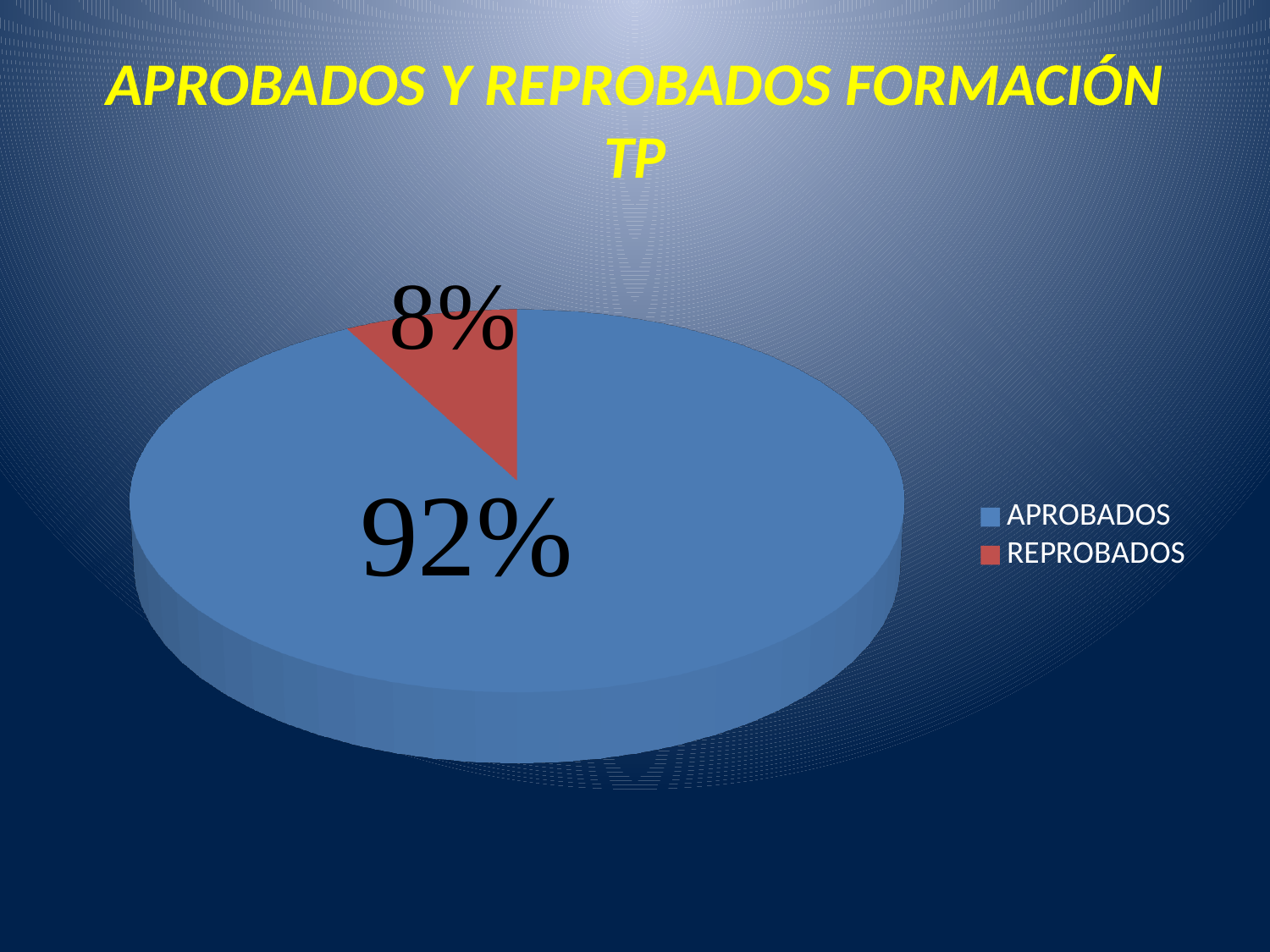
Which category has the smallest share of the pie? REPROBADOS What is the difference in percentage points between APROBADOS and REPROBADOS? 84 What is the title of the chart? APROBADOS Y REPROBADOS FORMACIÓN TP What share of the pie does the REPROBADOS slice represent? 8% What percentage of the pie is APROBADOS? 92% Which category has the largest share of the pie? APROBADOS Which is larger, the share for APROBADOS or the share for REPROBADOS? APROBADOS What percentage of the pie is REPROBADOS? 8% How many categories does the pie chart show? 2 How many entries does the legend list? 2 What kind of chart is shown on the slide? Pie chart What colour is the REPROBADOS slice? Red